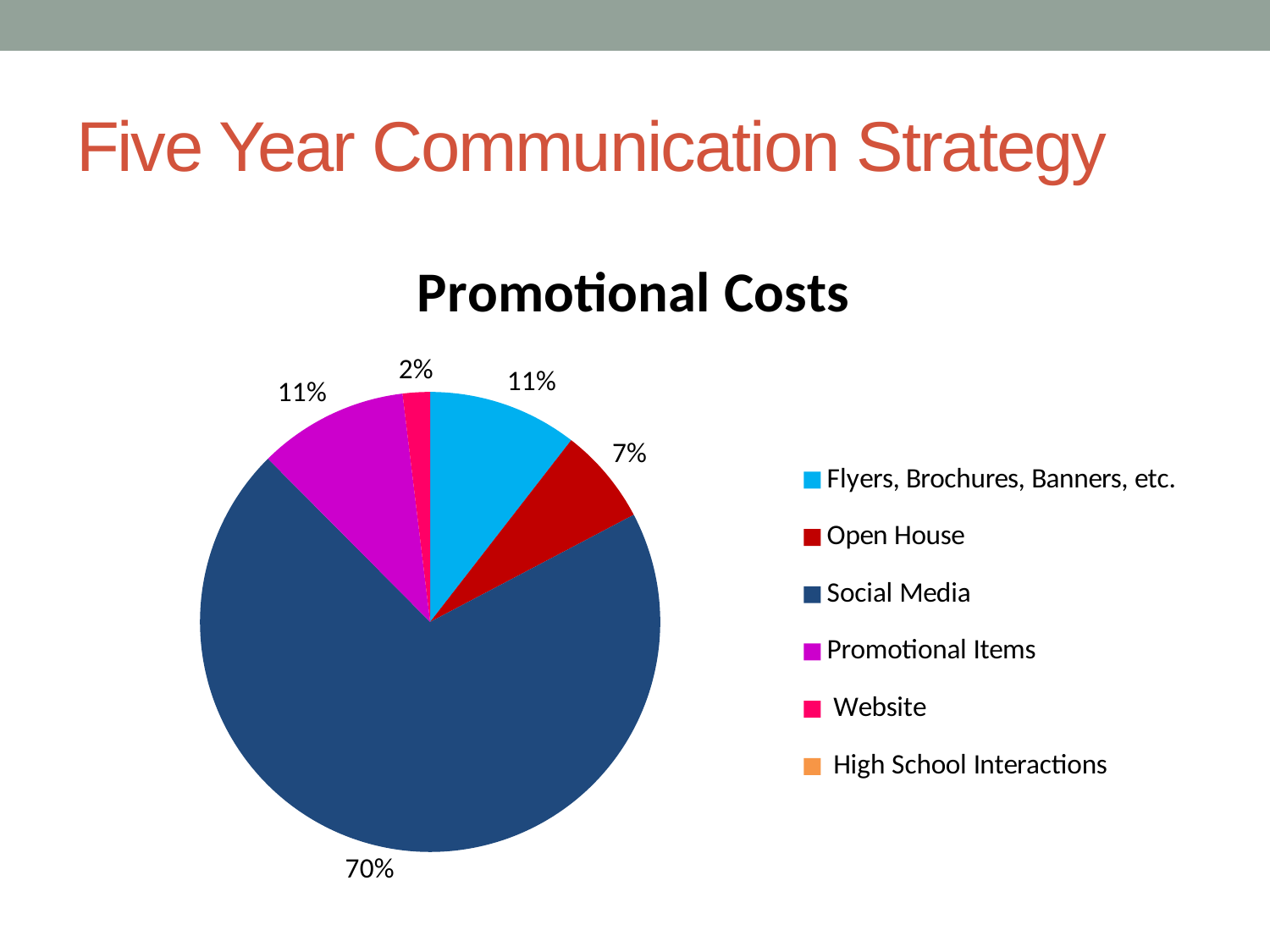
What percentage is shown for Website? 2% What percentage is shown for Flyers, Brochures, Banners, etc.? 11% What share of promotional costs goes to Social Media? 70% What is the title of the chart? Promotional Costs How many percentage points larger is the Social Media slice than the Open House slice? 63 What is the combined share of Flyers, Brochures, Banners, etc. and Promotional Items? 22% How many entries does the legend list? 6 What percentage is shown for Open House? 7% Which labeled slice of the pie is the smallest? Website Which is larger, the Open House slice or the Promotional Items slice? Promotional Items What kind of chart is shown on the slide? pie chart Which category has the largest slice of the pie? Social Media